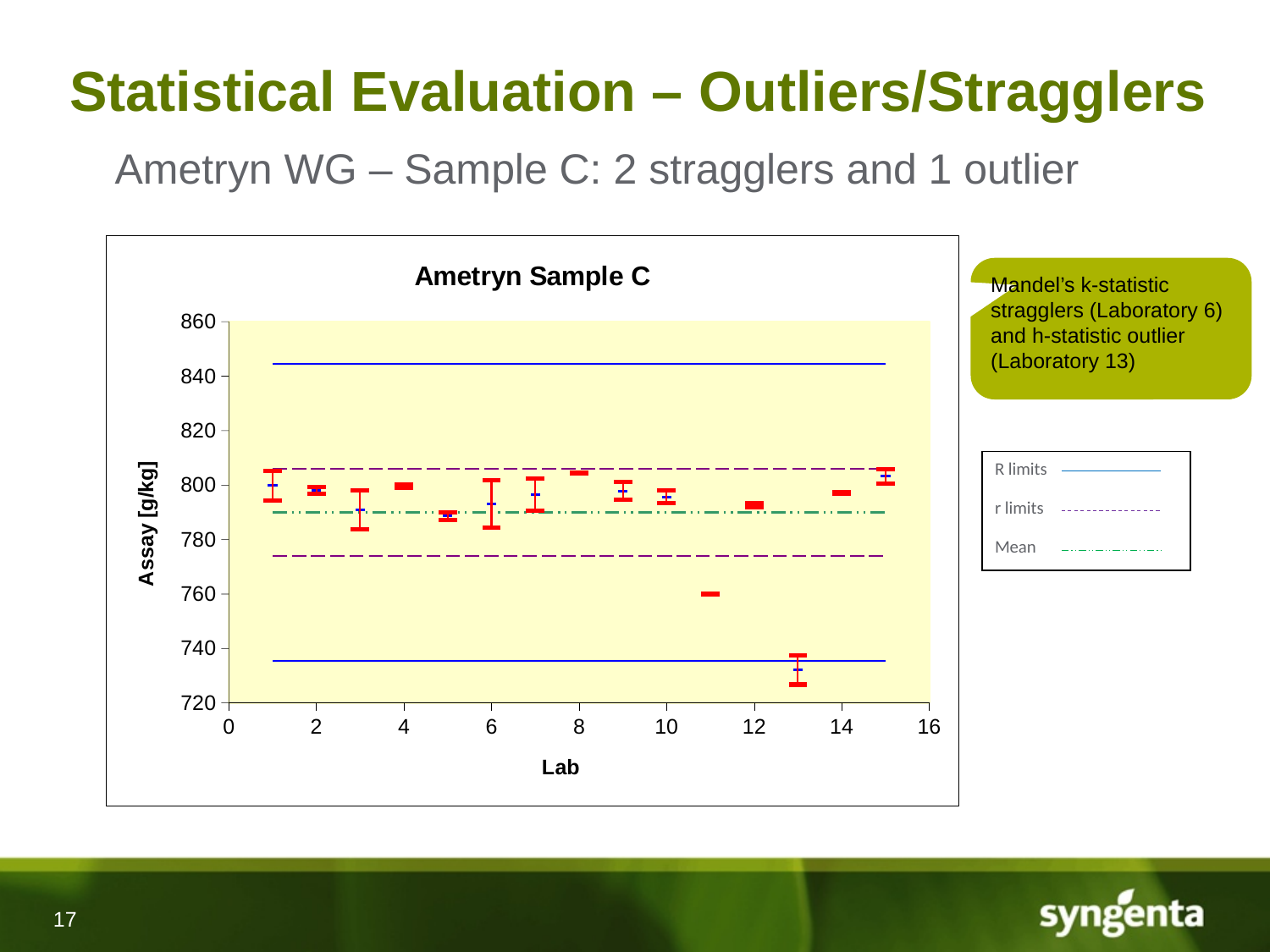
How many labs are plotted on the x-axis of the chart? 15 Is the assay value for Lab 11 greater or less than 780? less Which lab has the lowest assay value in the chart? Lab 13 What is the title of the chart? Ametryn Sample C Which has the larger assay value, Lab 1 or Lab 13? Lab 1 What is the label of the y-axis of the chart? Assay [g/kg] Is the assay value for Lab 12 greater or less than 780? greater Is the assay value for Lab 13 greater or less than 740? less What is the highest value shown on the y-axis of the chart? 860 How many entries does the legend of the chart list? 3 Which has the larger assay value, Lab 11 or Lab 13? Lab 11